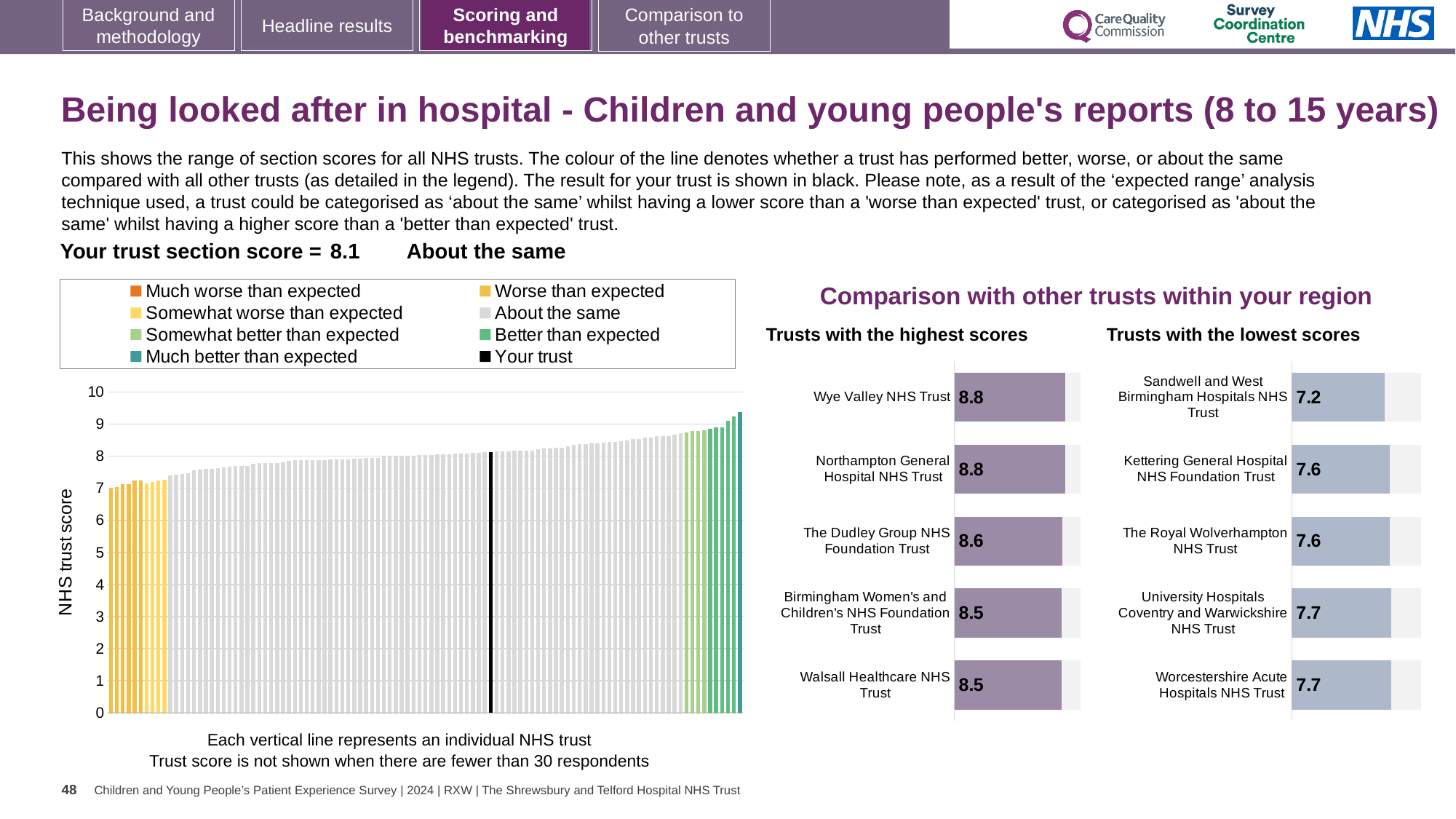
In the 'Trusts with the lowest scores' chart, what is the score for Sandwell and West Birmingham Hospitals NHS Trust? 7.2 In the 'Trusts with the lowest scores' chart, which trust has the lowest score? Sandwell and West Birmingham Hospitals NHS Trust In the 'Trusts with the lowest scores' chart, what is the difference between the scores of Worcestershire Acute Hospitals NHS Trust and Sandwell and West Birmingham Hospitals NHS Trust? 0.5 What is the y-axis label of the large chart on the left? NHS trust score What kind of chart is the large chart on the left showing NHS trust scores? Bar chart How many entries does the legend of the large chart on the left list? 8 In the large chart on the left, is the value for the black 'Your trust' bar greater or less than 8? greater In the 'Trusts with the highest scores' chart, what is the difference between the scores of Wye Valley NHS Trust and The Dudley Group NHS Foundation Trust? 0.2 In the 'Trusts with the lowest scores' chart, which has the larger score: Kettering General Hospital NHS Foundation Trust or Sandwell and West Birmingham Hospitals NHS Trust? Kettering General Hospital NHS Foundation Trust How many trusts are listed in the 'Trusts with the highest scores' chart? 5 In the 'Trusts with the highest scores' chart, what is the score for The Dudley Group NHS Foundation Trust? 8.6 In the 'Trusts with the highest scores' chart, what is the score for Wye Valley NHS Trust? 8.8